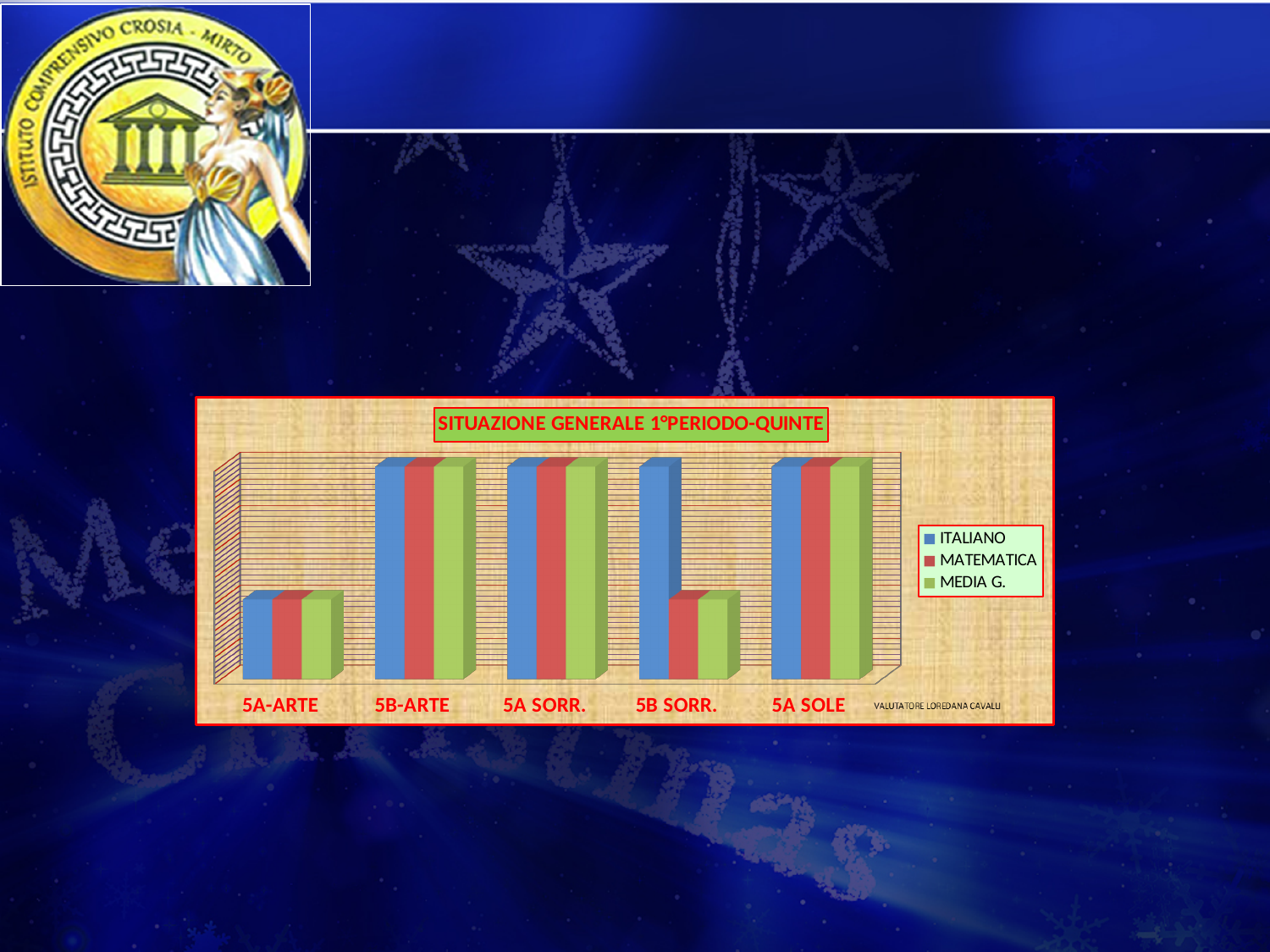
Which is larger: the MATEMATICA bar for 5A SORR. or the MATEMATICA bar for 5A-ARTE? 5A SORR. Which series is shown in red in the legend? MATEMATICA For 5B SORR., which is larger: the ITALIANO bar or the MATEMATICA bar? ITALIANO Which class has the lowest ITALIANO bar? 5A-ARTE How many series does the legend list? 3 Which is larger: the ITALIANO bar for 5A-ARTE or the ITALIANO bar for 5B-ARTE? 5B-ARTE What kind of chart is shown on the slide? bar chart How many class categories are shown on the x axis? 5 What is the title of the chart? SITUAZIONE GENERALE 1°PERIODO-QUINTE